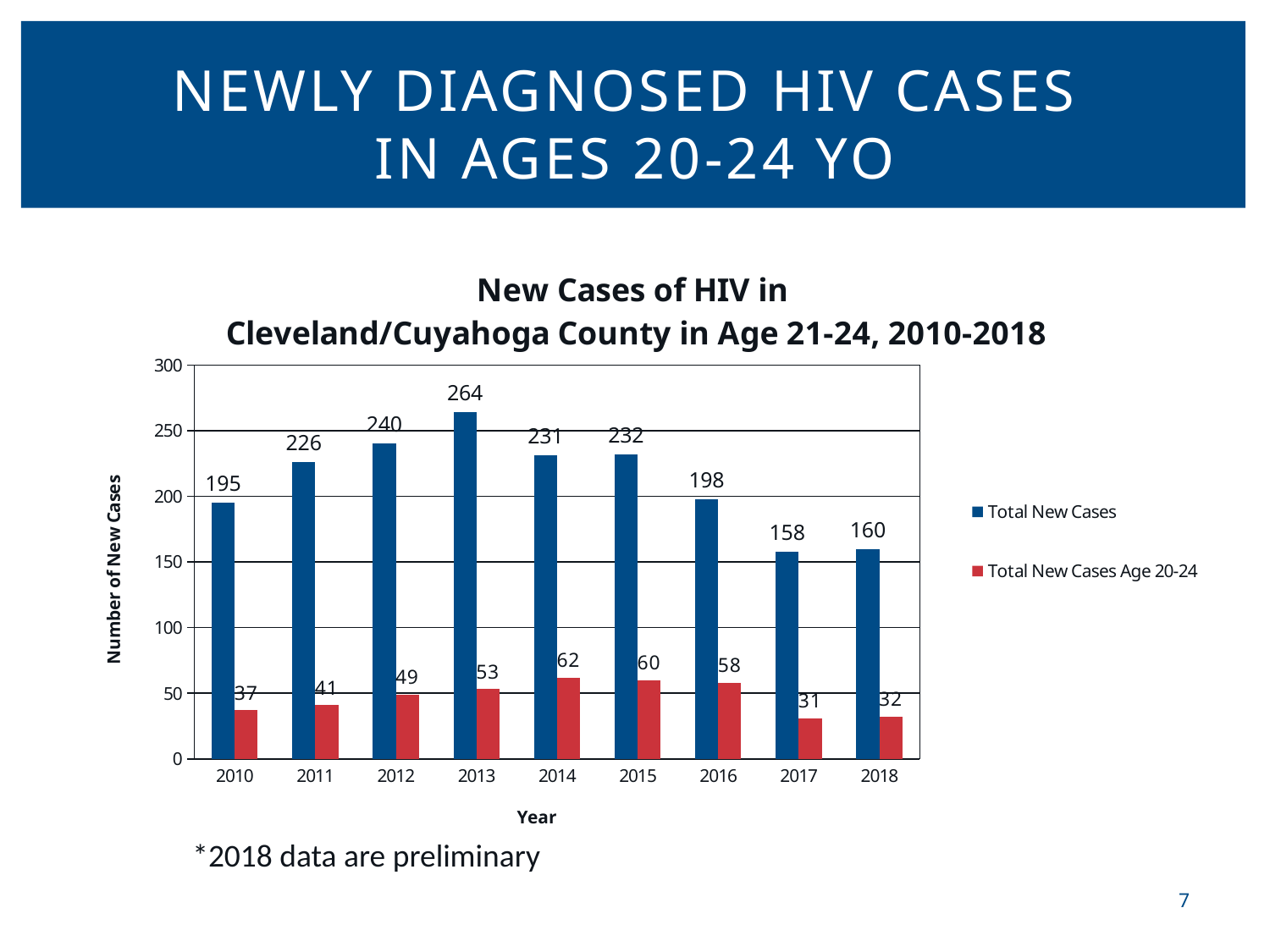
What is the difference between Total New Cases in 2013 and in 2018? 104 How many series does the legend list? 2 Which year has the highest value for Total New Cases? 2013 Which year has the lowest value for Total New Cases Age 20-24? 2017 What kind of chart is shown on the slide? bar chart Which is larger, Total New Cases Age 20-24 in 2012 or in 2016? 2016 What is the value for Total New Cases Age 20-24 in 2014? 62 What is the label of the y axis? Number of New Cases What is the value for Total New Cases in 2013? 264 How many years are shown on the x axis? 9 Is the value for Total New Cases in 2016 greater or less than 150? greater What is the value for Total New Cases in 2017? 158